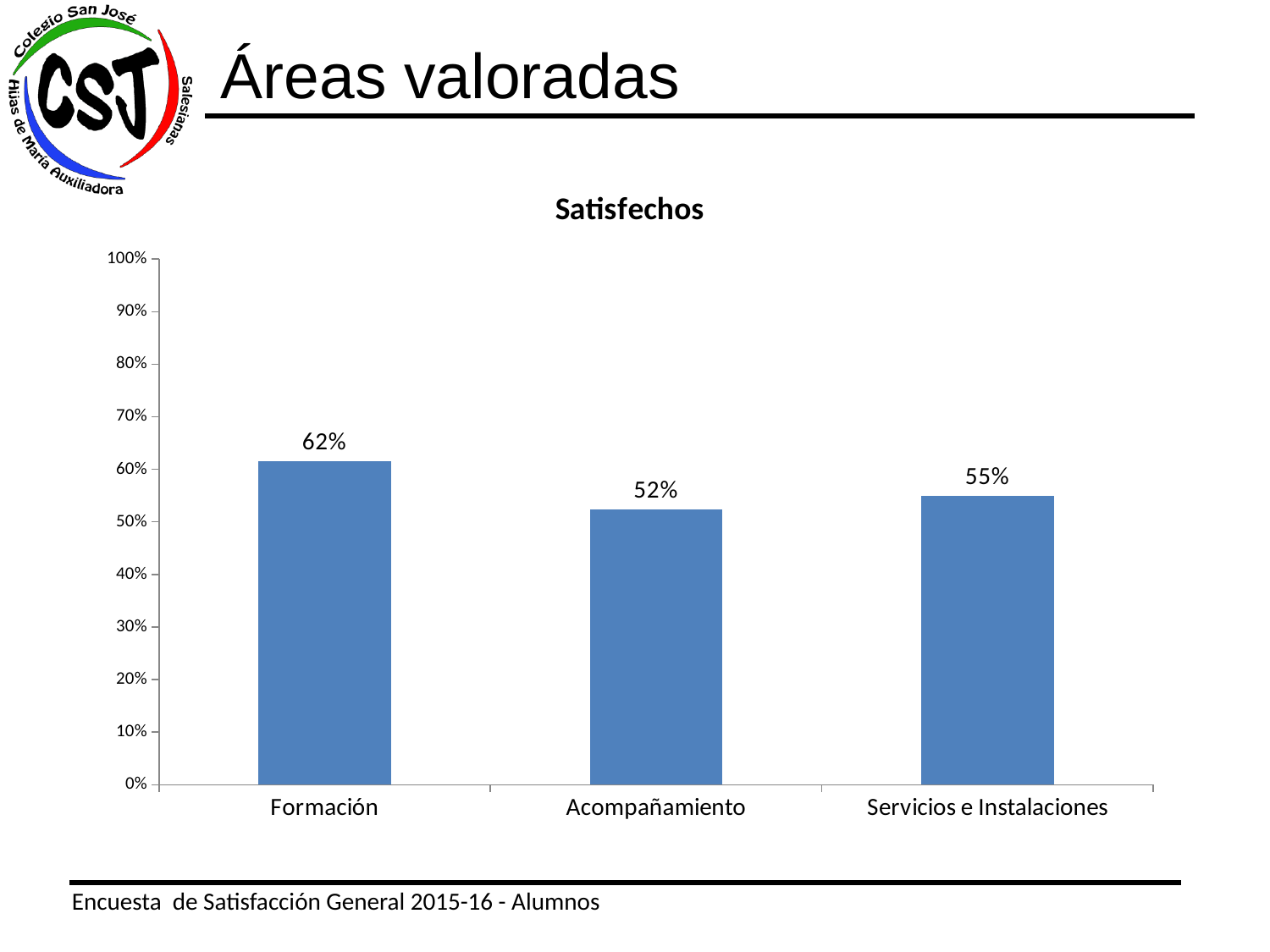
What kind of chart is shown on the slide? bar chart How many categories are shown in the chart? 3 What is the difference between the values for Formación and Acompañamiento? 10% Is the value for Acompañamiento greater or less than 60%? less Which category has the lowest value? Acompañamiento What is the difference between the values for Servicios e Instalaciones and Acompañamiento? 3% What is the title of the chart? Satisfechos Which category has the highest value? Formación What is the value for Acompañamiento? 52% What is the value for Formación? 62% What is the value for Servicios e Instalaciones? 55% Which is larger, the value for Formación or the value for Servicios e Instalaciones? Formación